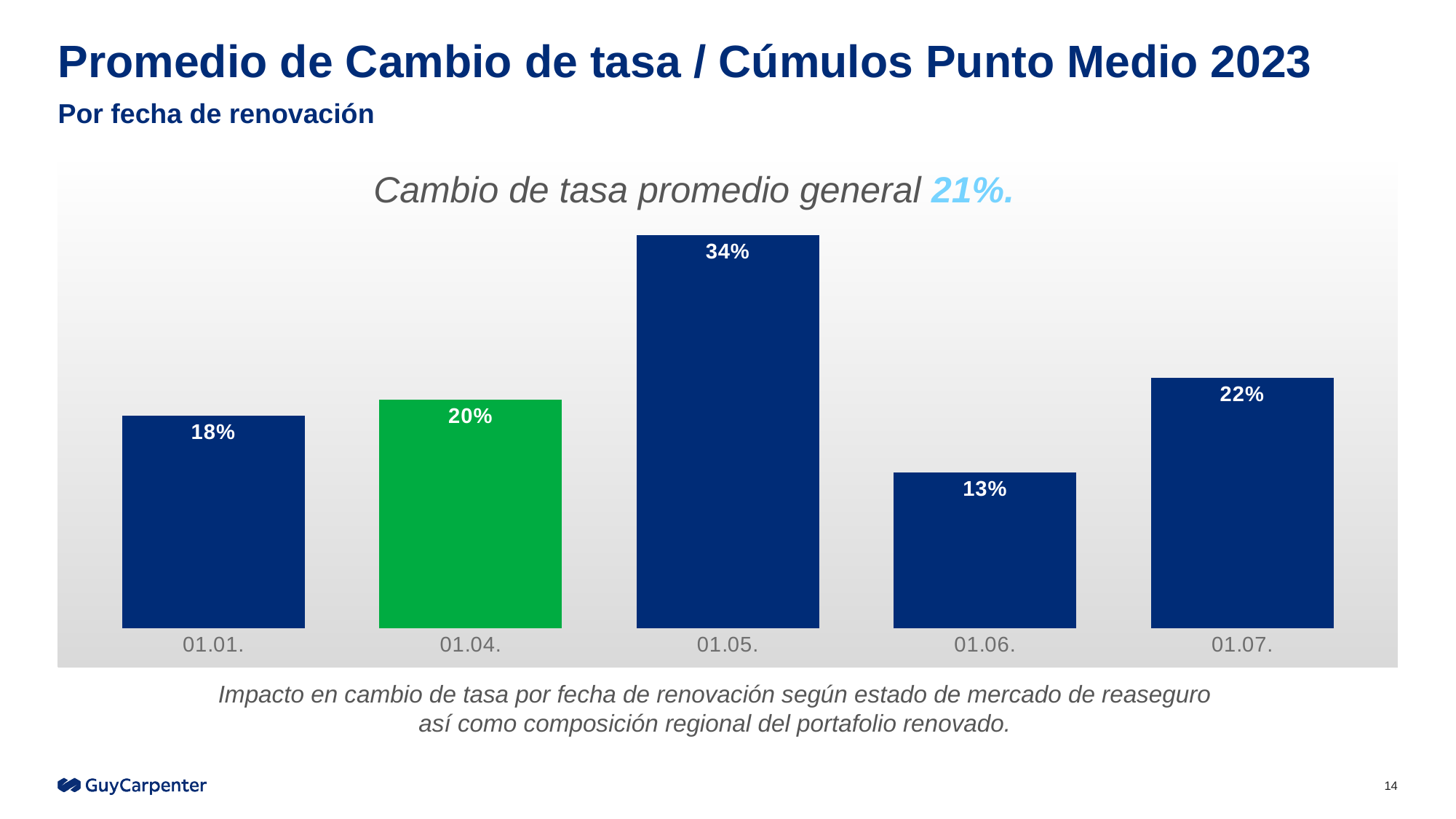
Which renewal date has the highest value? 01.05. What kind of chart is shown on the slide? Bar chart What is the value for 01.05.? 34% Which renewal date has the lowest value? 01.06. What is the value for 01.06.? 13% What is the difference between the values for 01.07. and 01.04.? 2% What is the value for 01.07.? 22% What is the difference between the values for 01.05. and 01.06.? 21% How many renewal dates are shown on the chart? 5 Which bar is shown in green rather than dark blue? 01.04. What is the value for 01.01.? 18% Which is larger, the value for 01.01. or the value for 01.04.? 01.04.